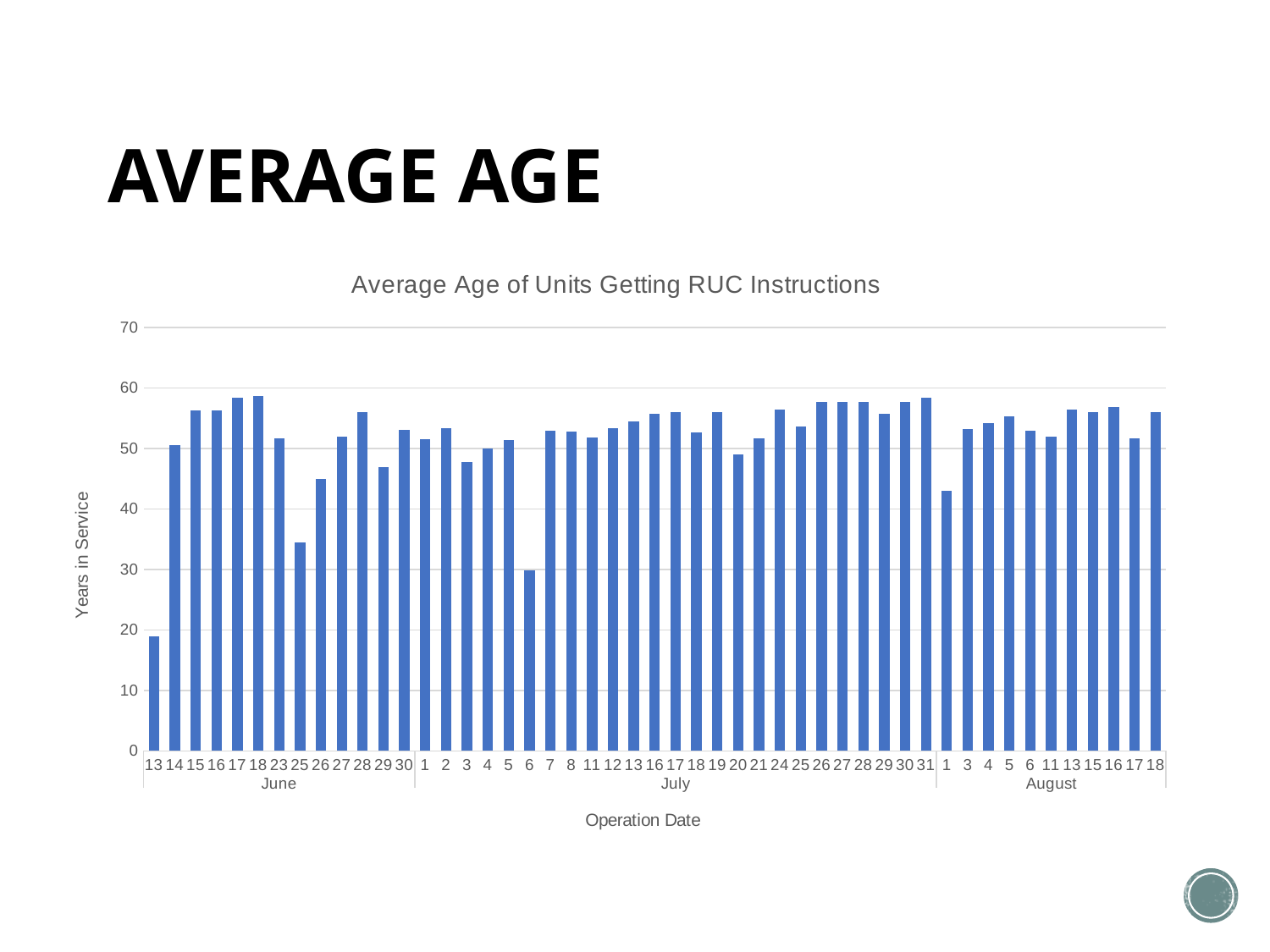
How many June operation dates are shown on the x axis? 13 Is the value for July 6 greater or less than 40? less Is the value for June 26 greater or less than 50? less What is the label of the y axis? Years in Service Is the value for July 26 greater or less than 50? greater Which is larger, the value for July 6 or the value for July 7? July 7 What kind of chart is shown on the slide? bar chart Which is larger, the value for June 25 or the value for August 1? August 1 Which operation date has the lowest average age? June 13